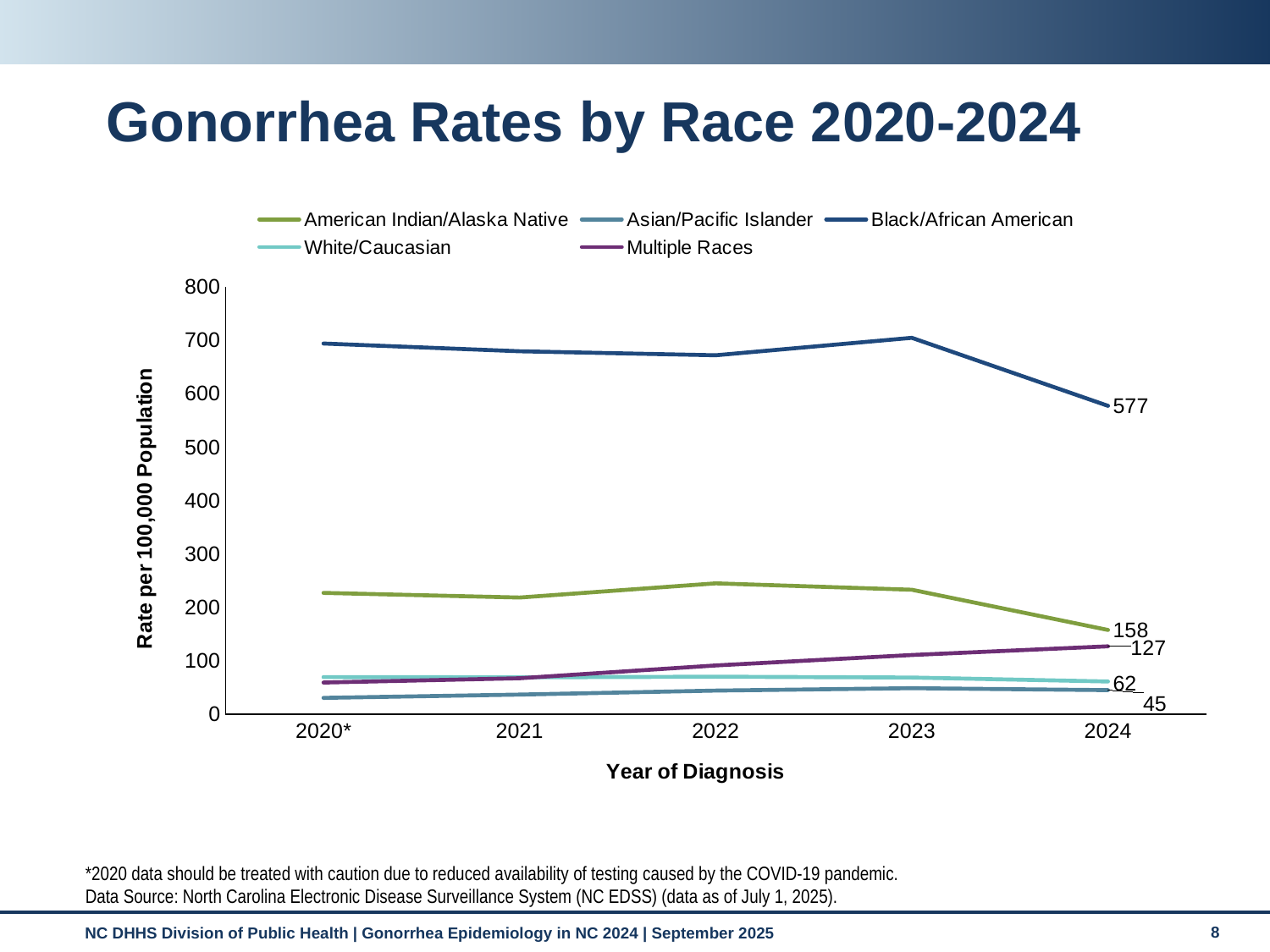
Which race has the lowest gonorrhea rate in 2024? Asian/Pacific Islander What is the difference between the 2024 rates for Black/African American and American Indian/Alaska Native? 419 Is the Black/African American rate in 2023 greater or less than 600? greater Does the Multiple Races rate rise or fall from 2020* to 2024? Rise What is the 2024 gonorrhea rate for Black/African American? 577 What type of chart is shown on the slide? Line chart Which race has the highest gonorrhea rate in 2024? Black/African American How many series does the legend list? 5 What is the 2024 gonorrhea rate for Multiple Races? 127 What is the 2024 gonorrhea rate for American Indian/Alaska Native? 158 What is the 2024 gonorrhea rate for Asian/Pacific Islander? 45 How many years are shown on the x axis? 5